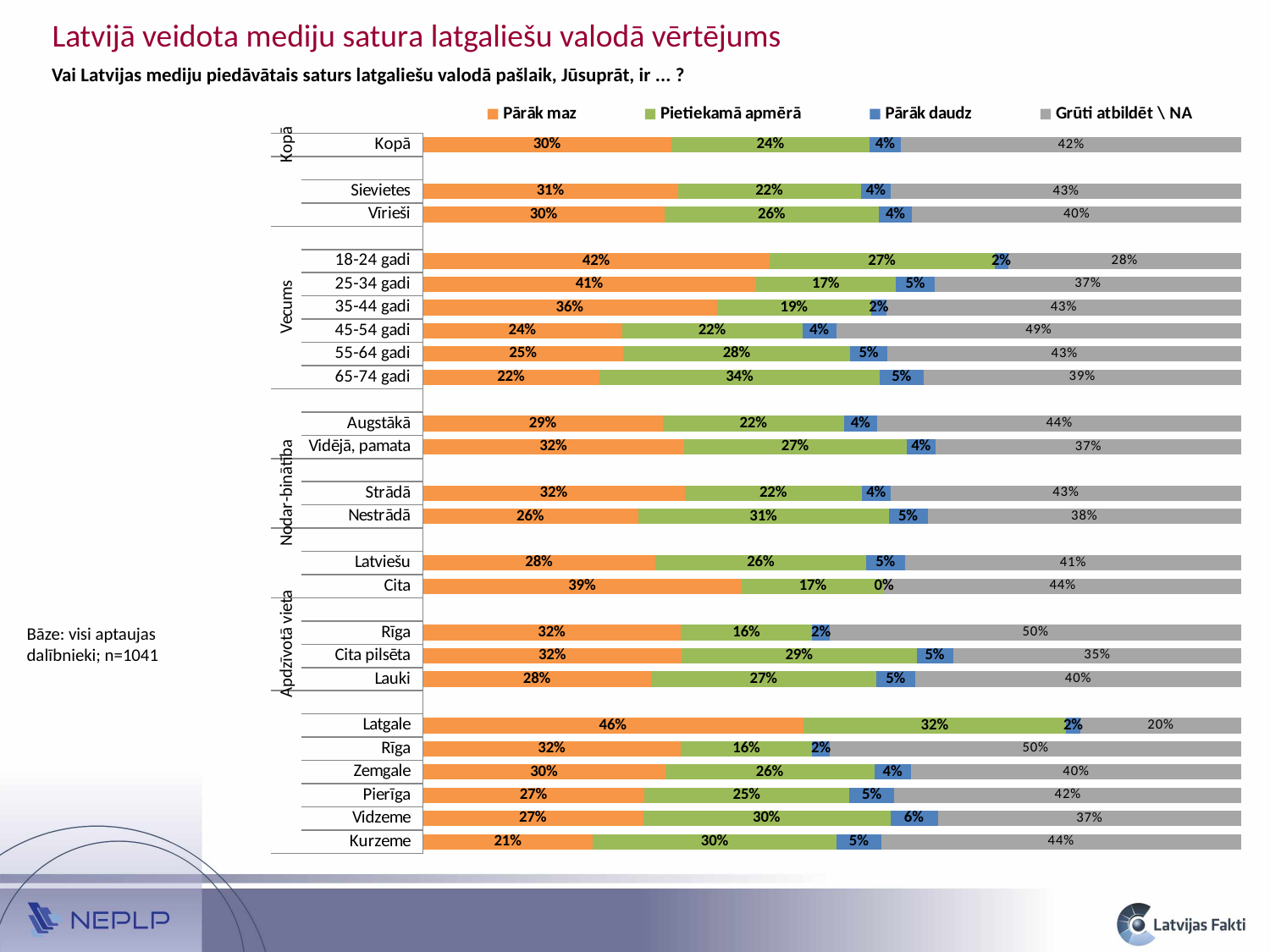
Which colour represents "Pārāk maz" in the legend? Orange What is the "Pārāk daudz" value for Vidzeme? 6% Which category has the highest "Pārāk maz" value? Latgale Which has a larger "Pietiekamā apmērā" value, Vidzeme or Pierīga? Vidzeme Which category has the lowest "Pārāk maz" value? Kurzeme What is the total of the four segments in the Kopā bar? 100% What is the "Pietiekamā apmērā" value for Latgale? 32% What is the "Pārāk daudz" value for the "Cita" category? 0% How many series does the legend list? 4 What kind of chart is shown on the slide? Stacked bar chart How many percentage points higher is the "Pārāk maz" value for 18-24 gadi than for 65-74 gadi? 20 percentage points What percentage of all respondents (Kopā) answered "Pārāk maz"? 30%